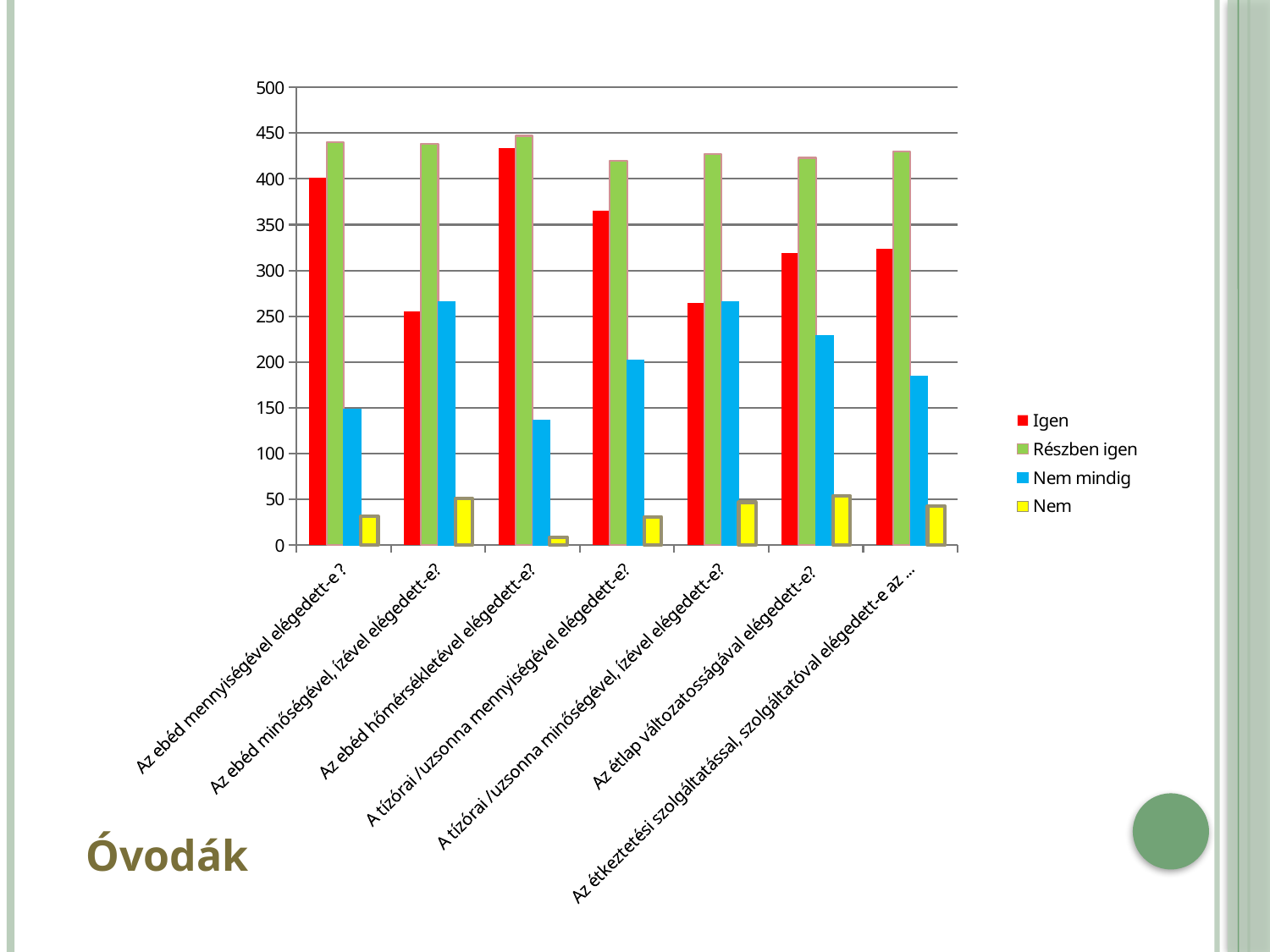
For which category is the 'Igen' value highest? Az ebéd hőmérsékletével elégedett-e? For 'Az ebéd minőségével, ízével elégedett-e?', which is larger: the 'Részben igen' value or the 'Igen' value? Részben igen What kind of chart is shown on the slide? Bar chart Which series is shown in red in the legend? Igen For 'A tízórai /uzsonna mennyiségével elégedett-e?', which is larger: the 'Igen' value or the 'Nem mindig' value? Igen How many series does the legend list? 4 How many question categories are shown along the x axis? 7 Is the 'Igen' value for 'Az ebéd mennyiségével elégedett-e ?' greater or less than 350? greater For which category is the 'Nem' value lowest? Az ebéd hőmérsékletével elégedett-e? Is the 'Nem mindig' value for 'Az ebéd minőségével, ízével elégedett-e?' greater or less than 250? greater Is the 'Nem' value for 'Az ebéd hőmérsékletével elégedett-e?' greater or less than 50? less What is the title text shown at the bottom left of the slide? Óvodák